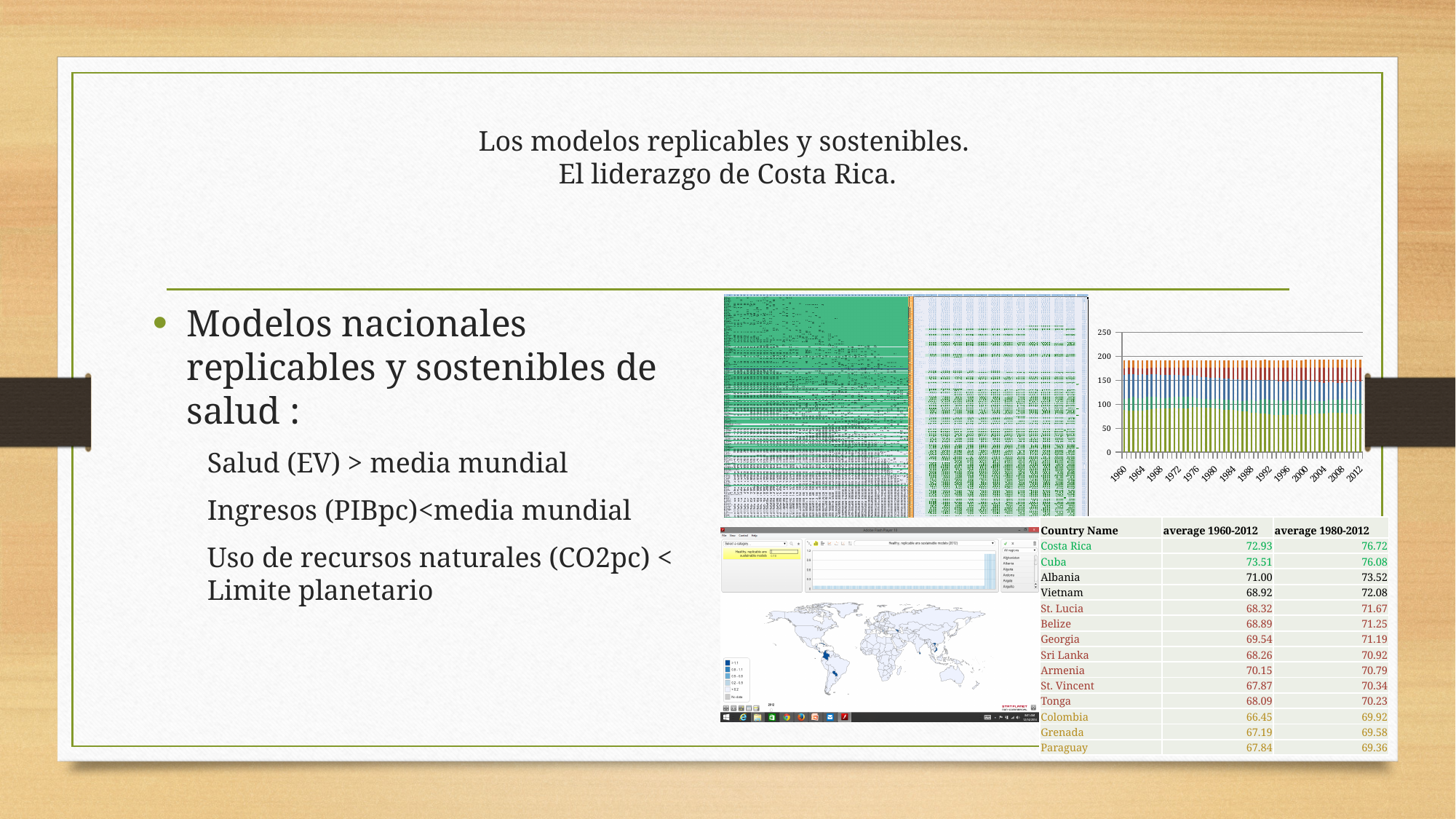
In the stacked bar chart, is the bottom (olive green) segment of the bar for 1980 greater or less than 50? greater What is the highest value shown on the y axis of the stacked bar chart? 250 In the stacked bar chart, is the bottom (olive green) segment of the bar for 2000 greater or less than 100? less In the stacked bar chart, what is the first year labelled on the x axis? 1960 In the stacked bar chart, is the total height of the bar for 2012 greater or less than 150? greater How many year labels are shown on the x axis of the stacked bar chart? 14 In the stacked bar chart, what is the last year labelled on the x axis? 2012 Do the total heights of the stacked bars rise, fall, or stay roughly flat from 1960 to 2012? roughly flat What colour is the bottom segment of each bar in the stacked bar chart? olive green What kind of chart is shown in the top right of the slide? stacked bar chart